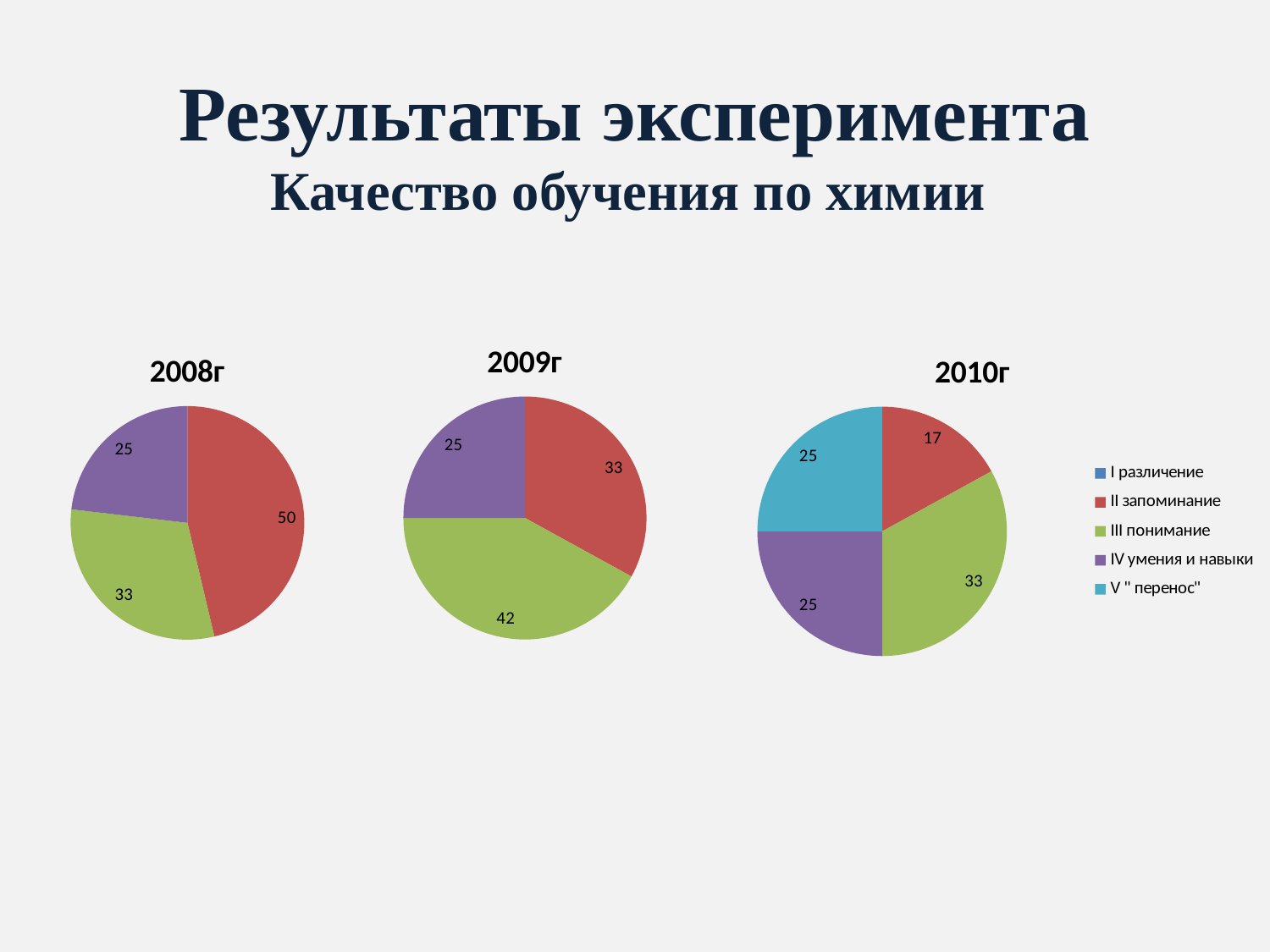
In the 2010г chart, what is the value for II запоминание? 17 In the 2008г chart, which category has the largest slice? II запоминание In the 2010г chart, which category has the smallest slice? II запоминание In the 2009г chart, which is larger: II запоминание or III понимание? III понимание In the 2008г chart, what is the value for II запоминание? 50 In the 2008г chart, what is the difference between the values for II запоминание and IV умения и навыки? 25 In the 2010г chart, what is the value for V " перенос"? 25 In the 2009г chart, what is the value for III понимание? 42 How many entries does the legend list? 5 In the 2009г chart, which category has the smallest slice? IV умения и навыки What kind of chart is the 2009г chart? Pie chart How many slices does the 2010г chart have? 4